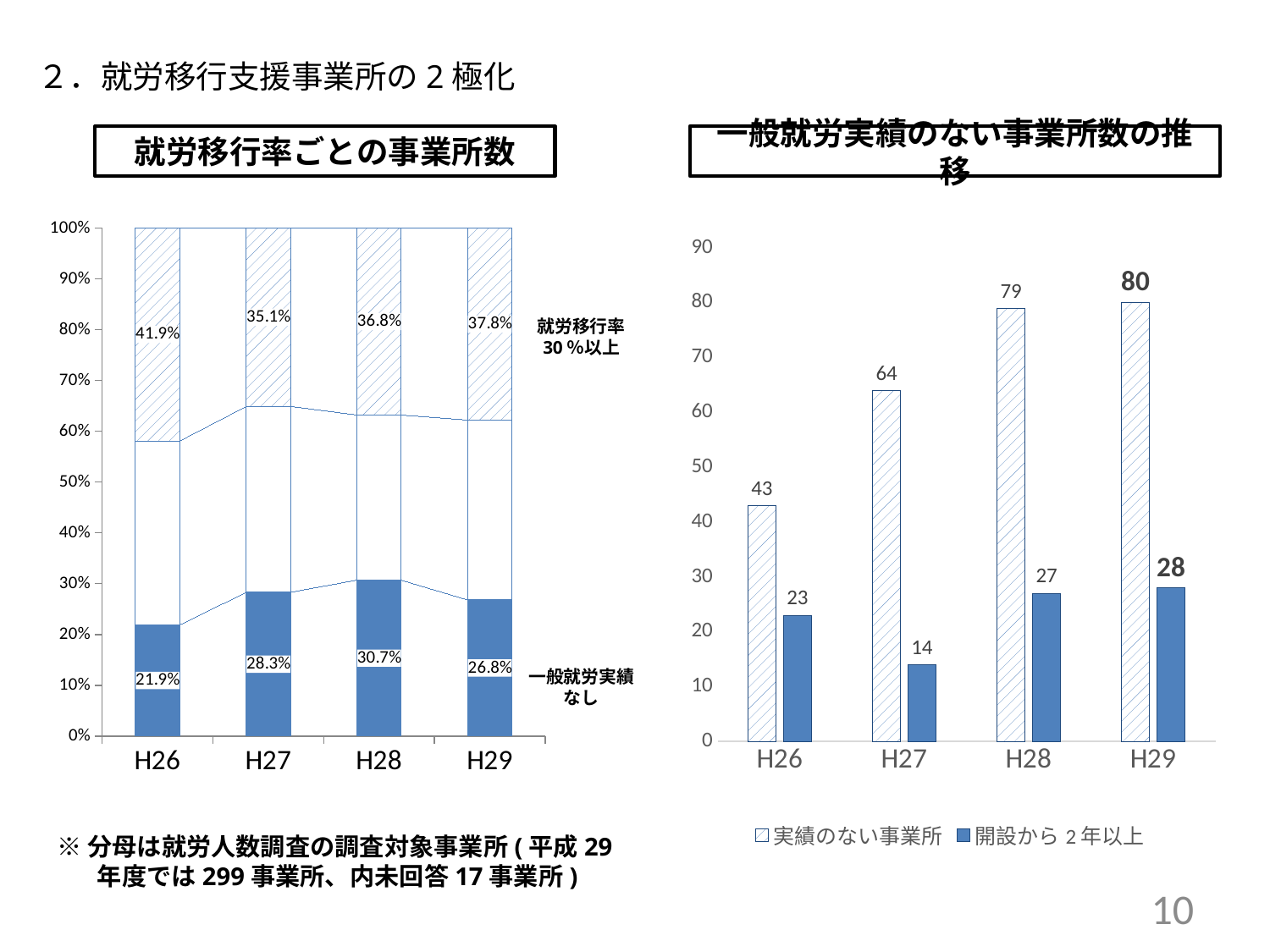
In the right chart (一般就労実績のない事業所数の推移), how many series does the legend list? 2 In the left chart (就労移行率ごとの事業所数), what is the share of 就労移行率30%以上 in H26? 41.9% In the right chart (一般就労実績のない事業所数の推移), what is the difference between 実績のない事業所 and 開設から2年以上 in H28? 52 What kind of chart is the right chart (一般就労実績のない事業所数の推移)? bar chart In the right chart (一般就労実績のない事業所数の推移), what is the value of 開設から2年以上 for H29? 28 In the left chart (就労移行率ごとの事業所数), what is the share of 一般就労実績なし in H28? 30.7% In the right chart (一般就労実績のない事業所数の推移), which year has the highest value for 実績のない事業所? H29 In the left chart (就労移行率ごとの事業所数), which year has the highest share of 就労移行率30%以上? H26 In the left chart (就労移行率ごとの事業所数), is the share of 一般就労実績なし larger in H27 or H29? H27 In the right chart (一般就労実績のない事業所数の推移), does the value for 実績のない事業所 rise or fall from H26 to H29? rise In the right chart (一般就労実績のない事業所数の推移), which year has the lowest value for 開設から2年以上? H27 In the right chart (一般就労実績のない事業所数の推移), what is the value of 実績のない事業所 for H27? 64